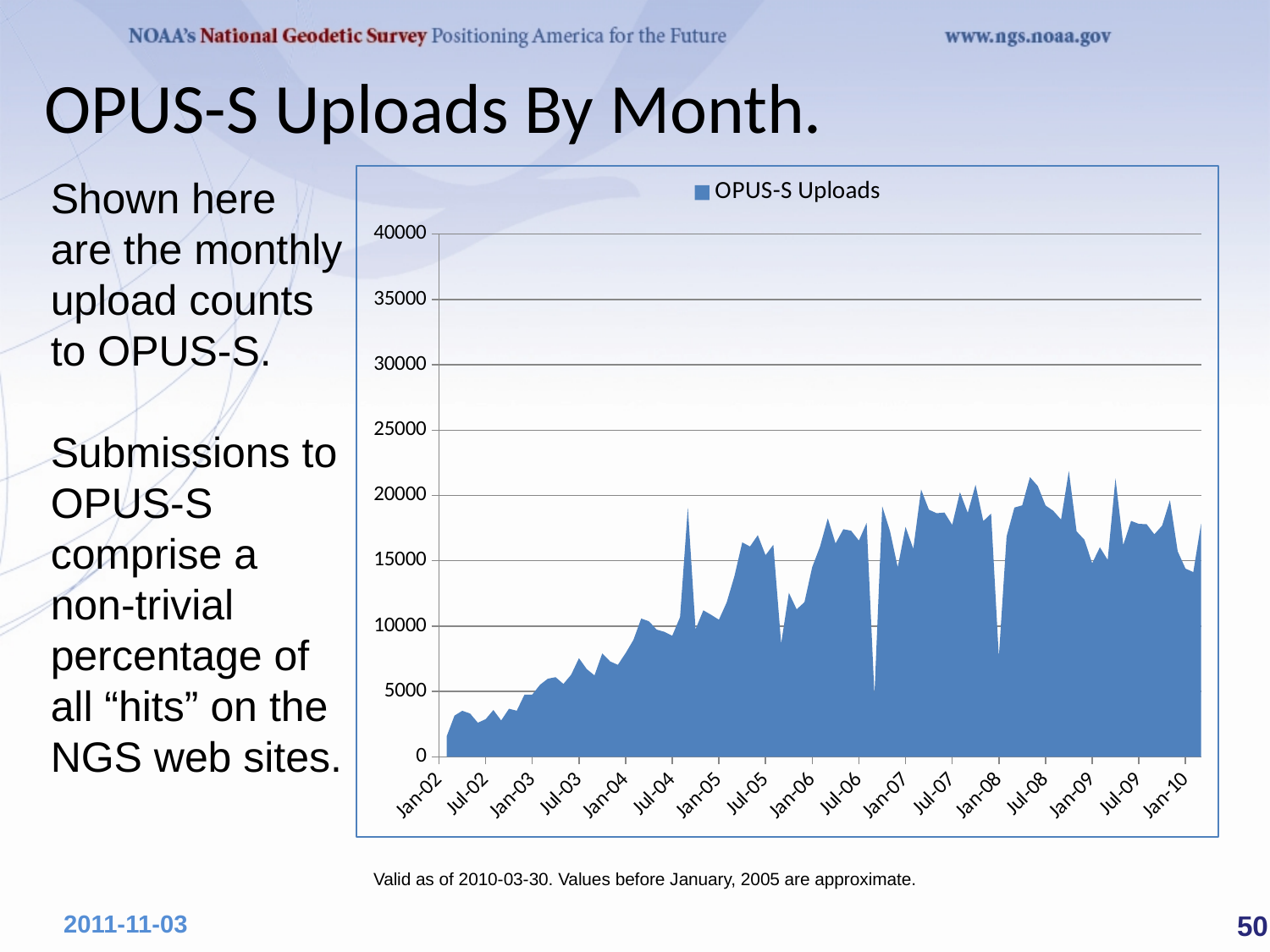
Is the value for Jan-02 greater or less than 5000? less What is the highest value labelled on the y axis? 40000 What is the name of the series shown in the chart legend? OPUS-S Uploads Is the value for Jul-06 greater or less than 15000? greater How many series does the chart legend list? 1 Overall, do the OPUS-S upload values rise or fall from Jan-02 to Jan-10? rise How many date labels are shown on the x axis? 17 Does any month's value exceed 25000? no What kind of chart is shown on the slide? area chart Which is larger, the value for Jul-02 or the value for Jul-06? Jul-06